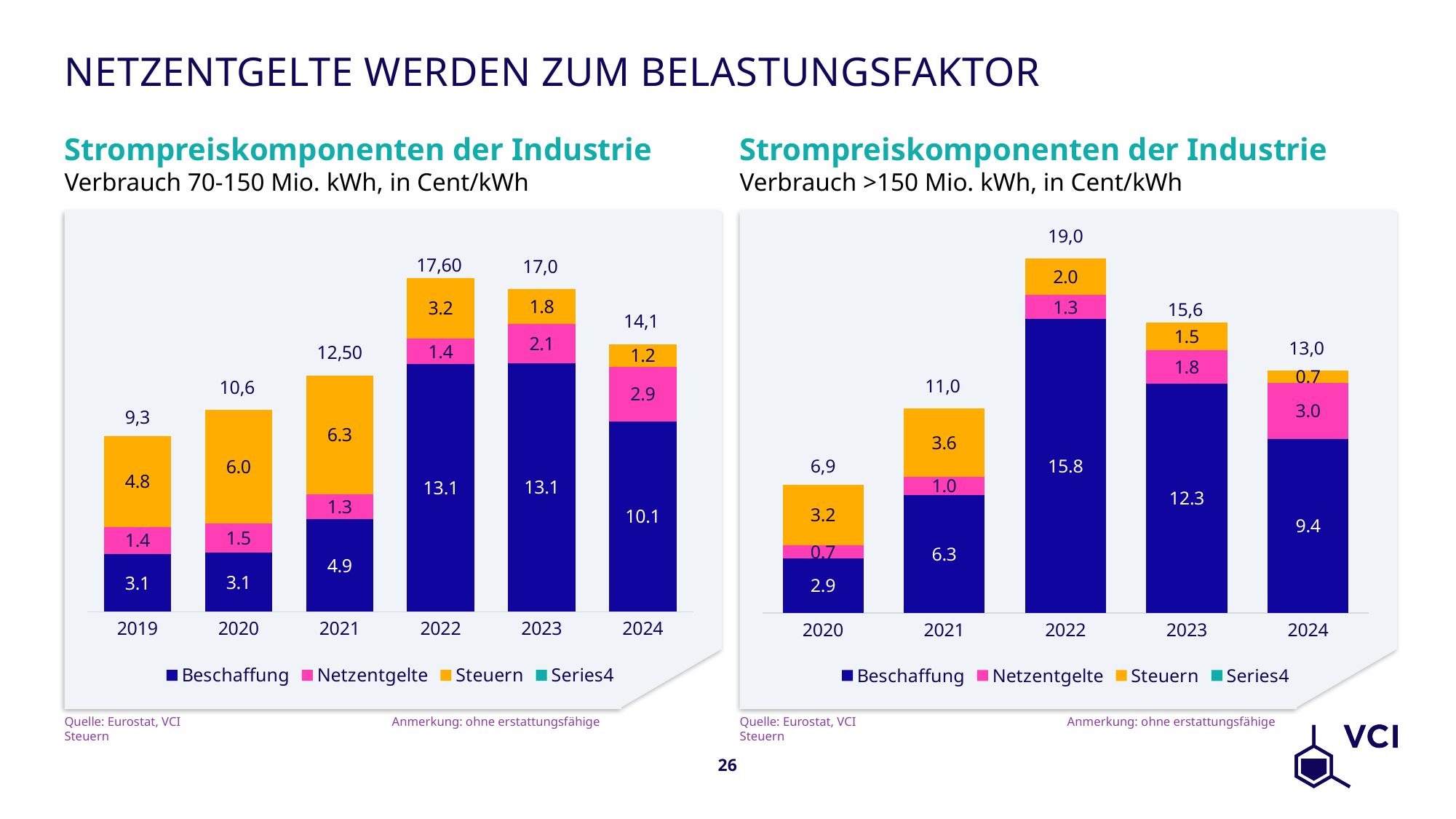
In the right chart (Verbrauch >150 Mio. kWh), what is the difference between the Beschaffung values for 2022 and 2023? 3.5 In the left chart (Verbrauch 70-150 Mio. kWh), what is the Beschaffung value for 2022? 13.1 In the right chart (Verbrauch >150 Mio. kWh), what is the total shown above the 2020 bar? 6,9 In the left chart (Verbrauch 70-150 Mio. kWh), what is the Steuern value for 2021? 6.3 In the left chart (Verbrauch 70-150 Mio. kWh), what is the total shown above the 2024 bar? 14,1 How many years are shown on the x axis of the right chart (Verbrauch >150 Mio. kWh)? 5 In the left chart (Verbrauch 70-150 Mio. kWh), is the Netzentgelte value larger in 2024 or in 2019? 2024 In the right chart (Verbrauch >150 Mio. kWh), what is the Netzentgelte value for 2024? 3.0 How many series does the legend of the left chart (Verbrauch 70-150 Mio. kWh) list? 4 In the left chart (Verbrauch 70-150 Mio. kWh), which year has the lowest total stacked bar? 2019 What kind of chart is the left chart (Verbrauch 70-150 Mio. kWh)? Stacked bar chart In the right chart (Verbrauch >150 Mio. kWh), which year has the highest total stacked bar? 2022